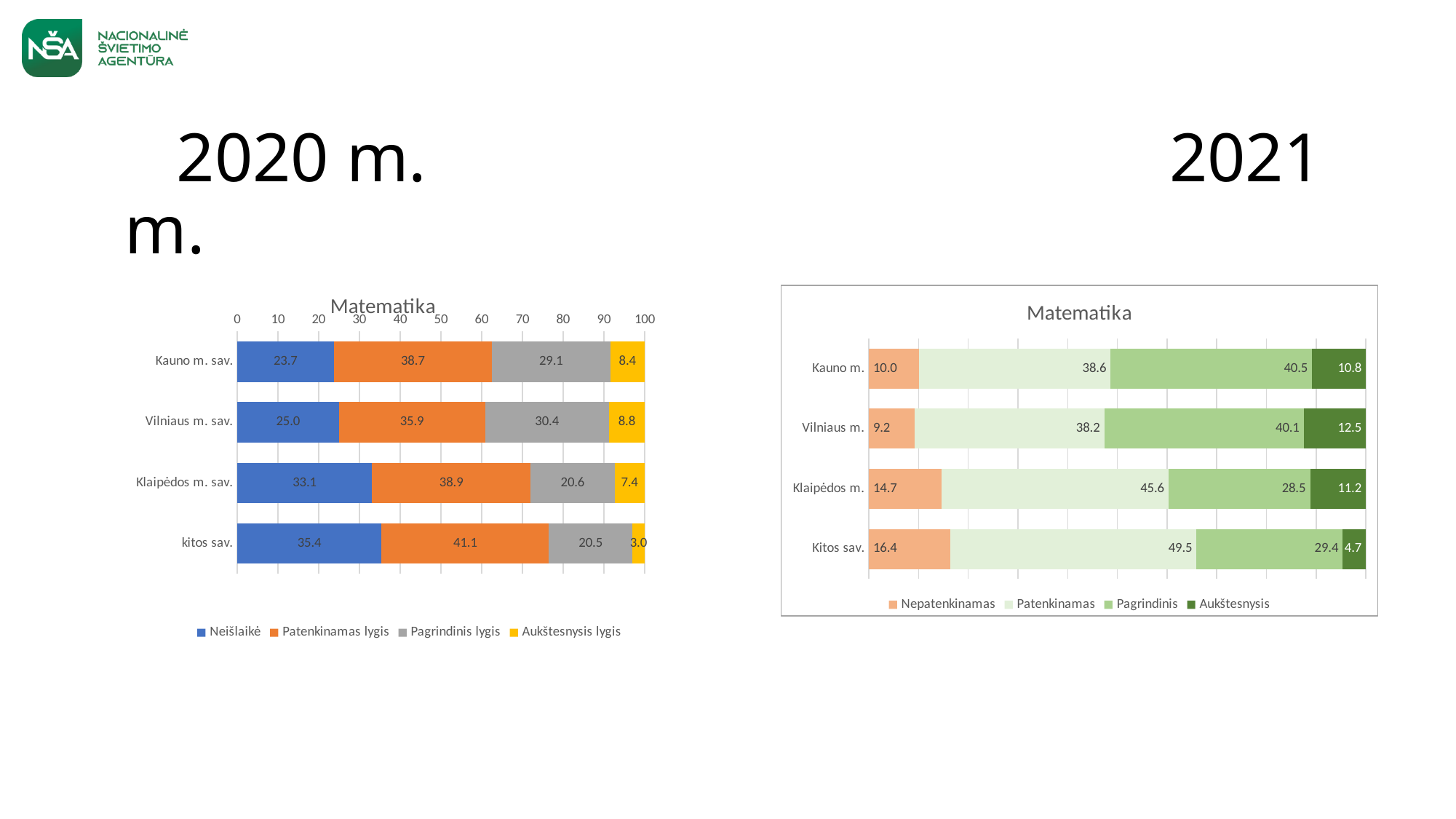
In the left chart (2020 m.), which category has the highest Neišlaikė value? kitos sav. In the left chart (2020 m.), what is the Aukštesnysis lygis value for kitos sav.? 3.0 What type of chart is the right chart (2021 m.)? Stacked bar chart In the right chart (2021 m.), what is the Aukštesnysis value for Vilniaus m.? 12.5 In the right chart (2021 m.), what is the total of the stacked bar for Kitos sav.? 100.0 In the right chart (2021 m.), which category has the lowest Aukštesnysis value? Kitos sav. How many categories are shown in the right chart (2021 m.)? 4 In the left chart (2020 m.), which is larger: the Pagrindinis lygis value for Vilniaus m. sav. or for Klaipėdos m. sav.? Vilniaus m. sav. How many series does the legend of the left chart (2020 m.) list? 4 In the right chart (2021 m.), what is the difference between the Nepatenkinamas values for Kitos sav. and Vilniaus m.? 7.2 In the right chart (2021 m.), what is the Patenkinamas value for Klaipėdos m.? 45.6 In the left chart (2020 m.), what is the Neišlaikė value for Kauno m. sav.? 23.7